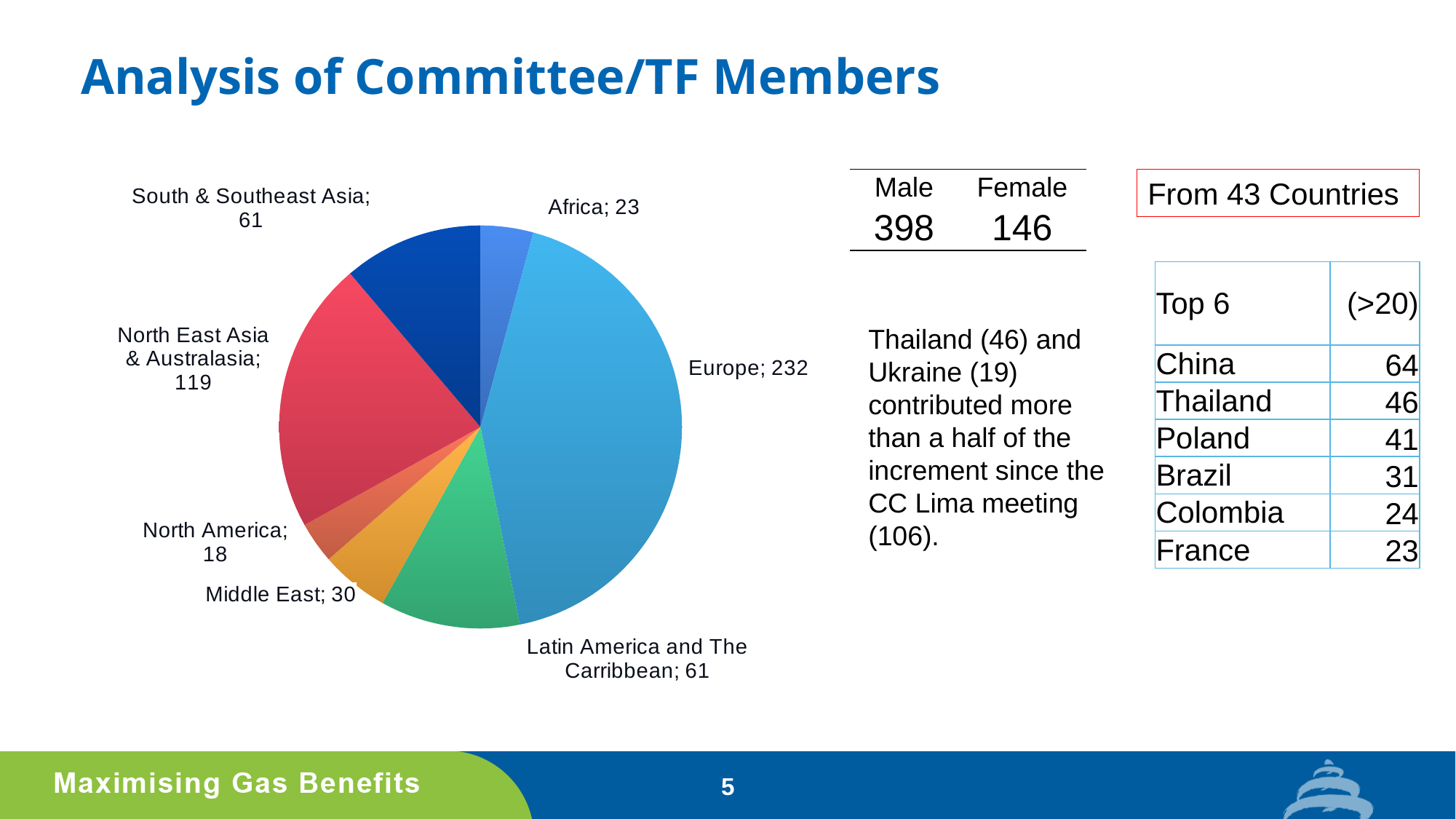
What is the value for Europe in the pie chart? 232 Which is larger in the pie chart, Middle East or Africa? Middle East What is the total of all the slice values in the pie chart? 544 How many regions are shown in the pie chart? 7 What is the difference between the values for Europe and North East Asia & Australasia in the pie chart? 113 Which region has the smallest slice in the pie chart? North America What kind of chart is shown on the slide? Pie chart What is the difference between the values for Latin America and The Carribbean and Africa in the pie chart? 38 What is the value for North East Asia & Australasia in the pie chart? 119 What is the value for Latin America and The Carribbean in the pie chart? 61 What is the value for Middle East in the pie chart? 30 Which region has the largest slice in the pie chart? Europe